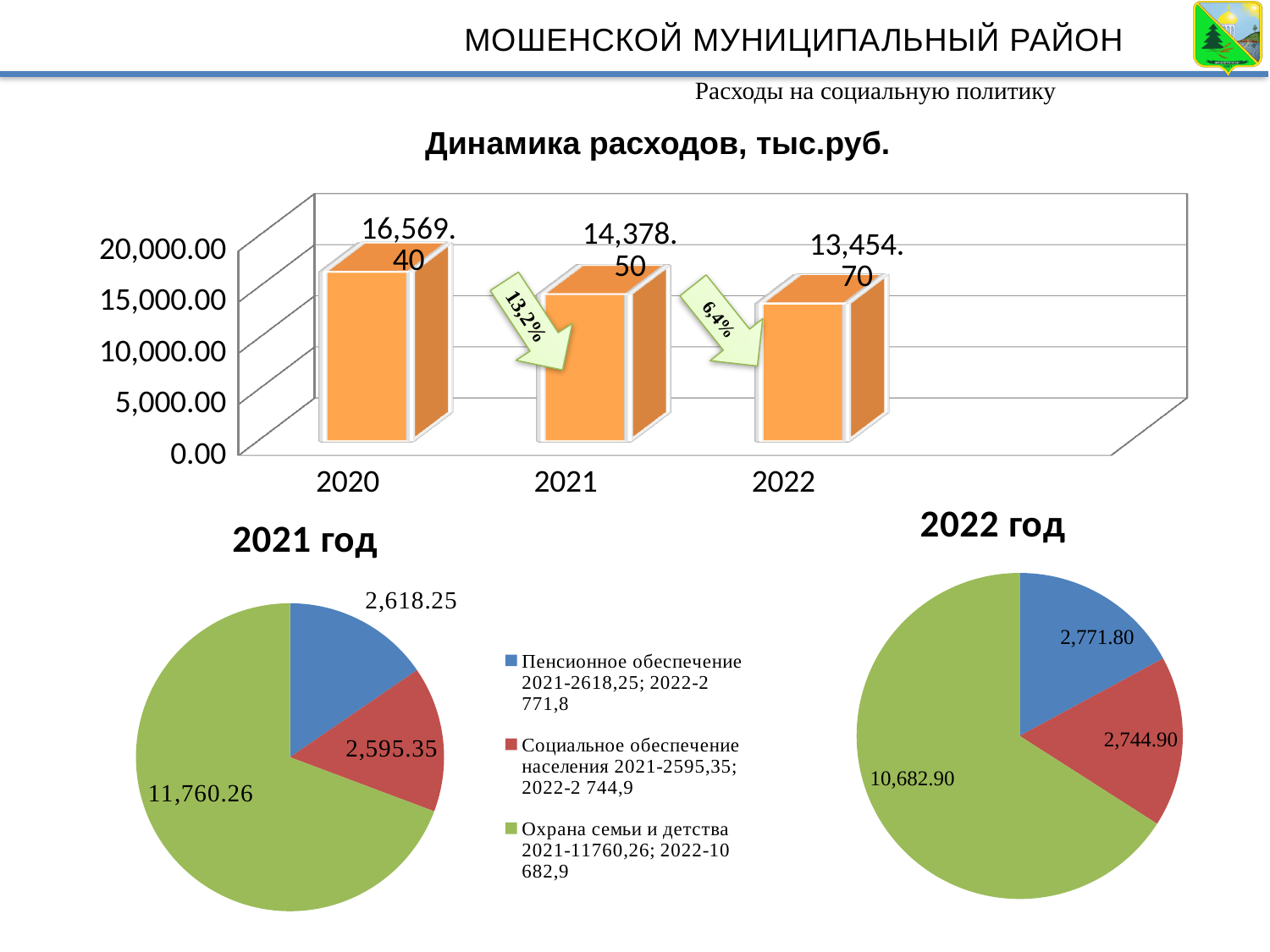
In the chart 'Динамика расходов, тыс.руб.', what is the value for 2020? 16,569.40 In the chart 'Динамика расходов, тыс.руб.', what is the value for 2022? 13,454.70 In the chart 'Динамика расходов, тыс.руб.', what kind of chart is it? bar chart In the pie chart '2021 год', what is the value for Охрана семьи и детства? 11,760.26 In the chart 'Динамика расходов, тыс.руб.', which year has the highest value? 2020 How many categories does the legend of the pie charts list? 3 In the chart 'Динамика расходов, тыс.руб.', how many years are shown? 3 In the chart 'Динамика расходов, тыс.руб.', what is the difference between the 2020 and 2021 values? 2,190.90 In the pie chart '2021 год', which category has the smallest slice? Социальное обеспечение населения In the chart 'Динамика расходов, тыс.руб.', do the values rise or fall from 2020 to 2022? fall In the pie chart '2022 год', what is the difference between Пенсионное обеспечение and Социальное обеспечение населения? 26.90 In the pie chart '2022 год', what is the value for Пенсионное обеспечение? 2,771.80